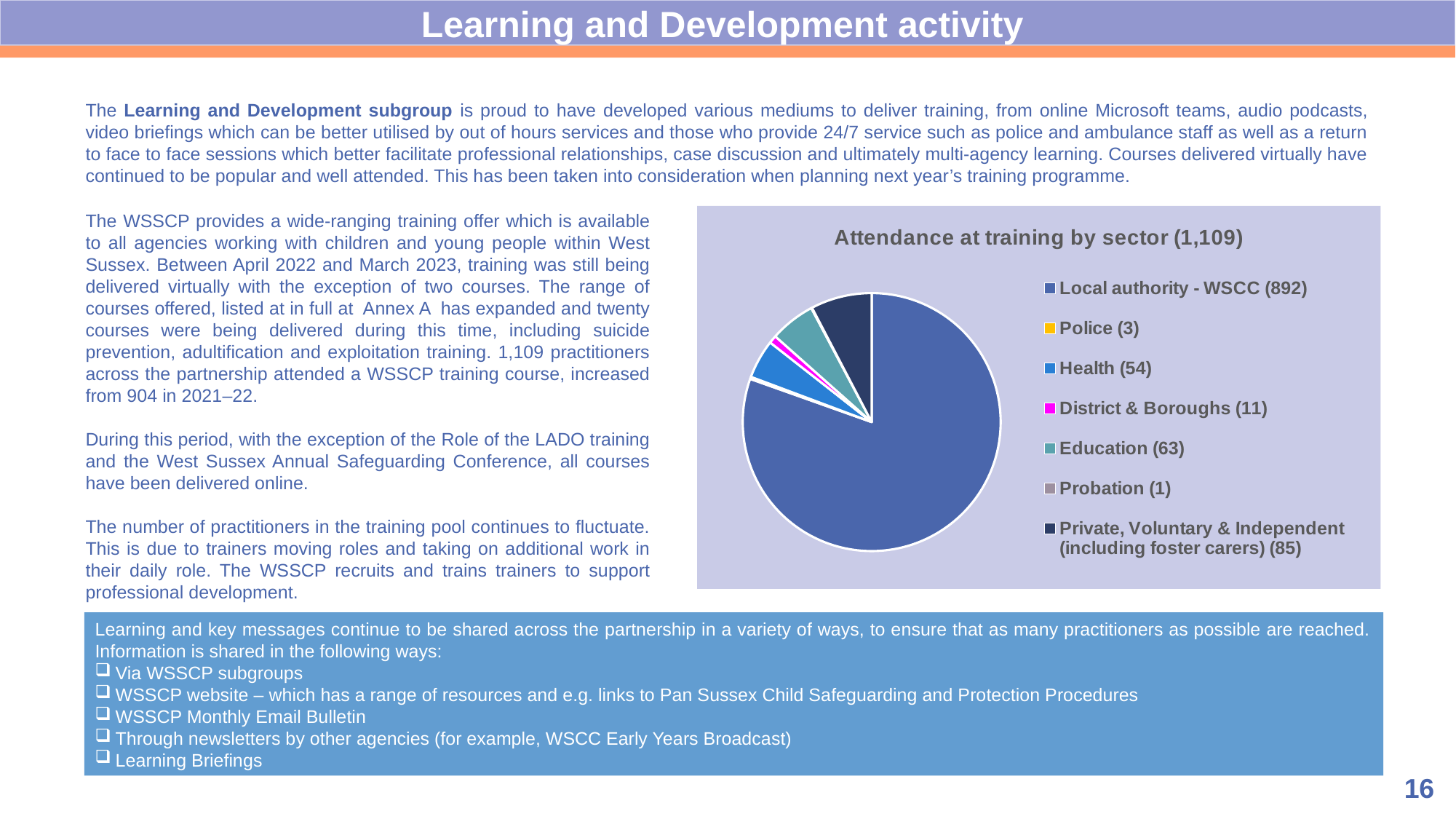
Which sector has the lowest attendance at training? Probation What is the attendance value for Education? 63 What is the difference in attendance between Education and Health? 9 Which sector has the highest attendance at training? Local authority - WSCC What is the attendance value for District & Boroughs? 11 What is the attendance value for Health? 54 What is the difference in attendance between Local authority - WSCC and Private, Voluntary & Independent (including foster carers)? 807 What is the attendance value for Private, Voluntary & Independent (including foster carers)? 85 What kind of chart is shown on the slide? pie chart Which has higher attendance, Health or Education? Education What is the attendance value for Local authority - WSCC? 892 How many sectors are listed in the pie chart legend? 7